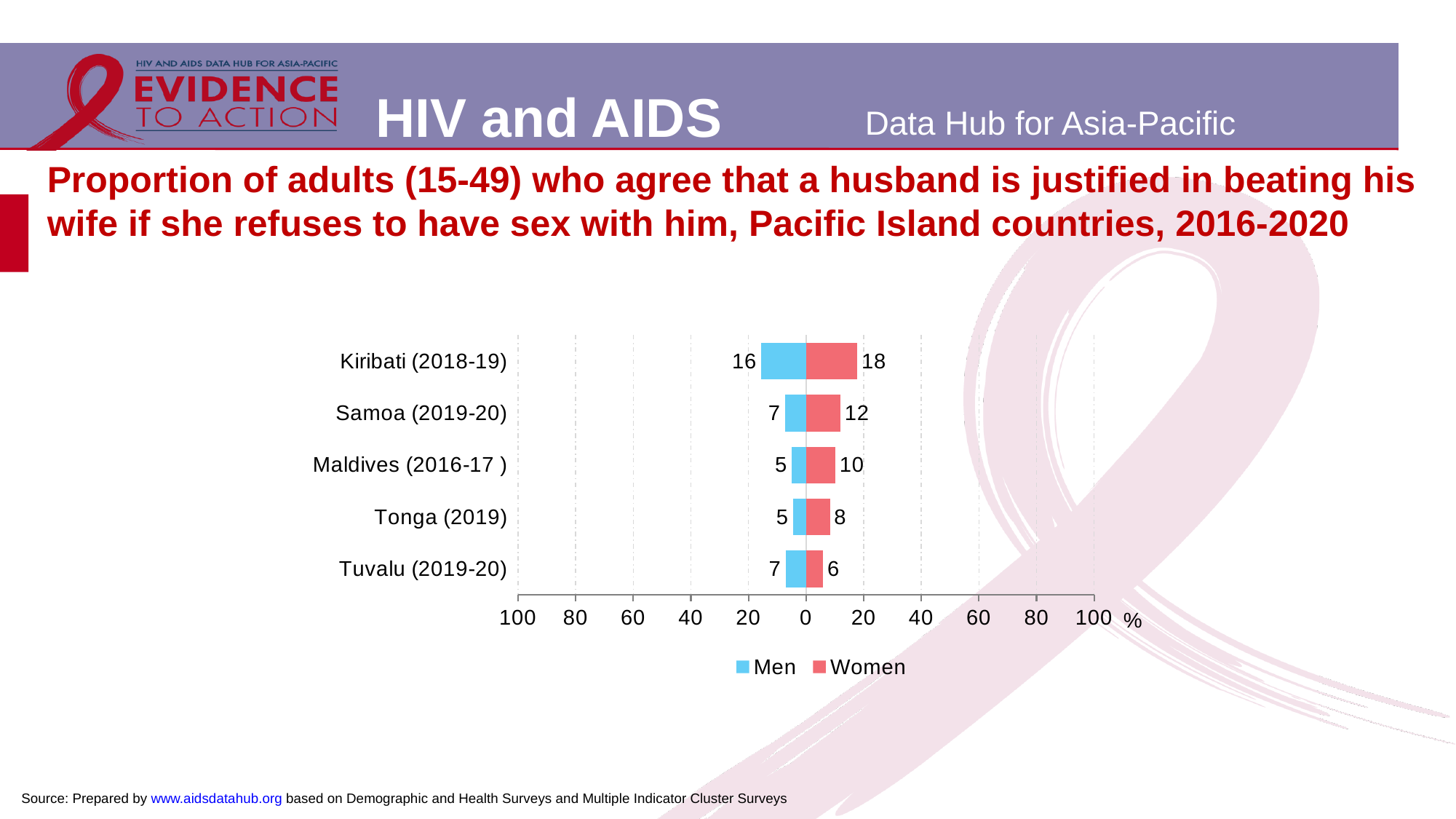
What is the value for Women in Kiribati (2018-19)? 18 Which is larger for Tuvalu (2019-20), the Men value or the Women value? Men What is the difference between the Women and Men values for Samoa (2019-20)? 5 How many series does the legend list? 2 What is the value for Women in Tuvalu (2019-20)? 6 Which country has the highest value for Women? Kiribati (2018-19) Which colour represents Women in the chart? Red Which country has the lowest value for Women? Tuvalu (2019-20) How many countries are shown in the chart? 5 What kind of chart is shown on the slide? Bar chart What is the value for Men in Tonga (2019)? 5 What is the value for Men in Samoa (2019-20)? 7